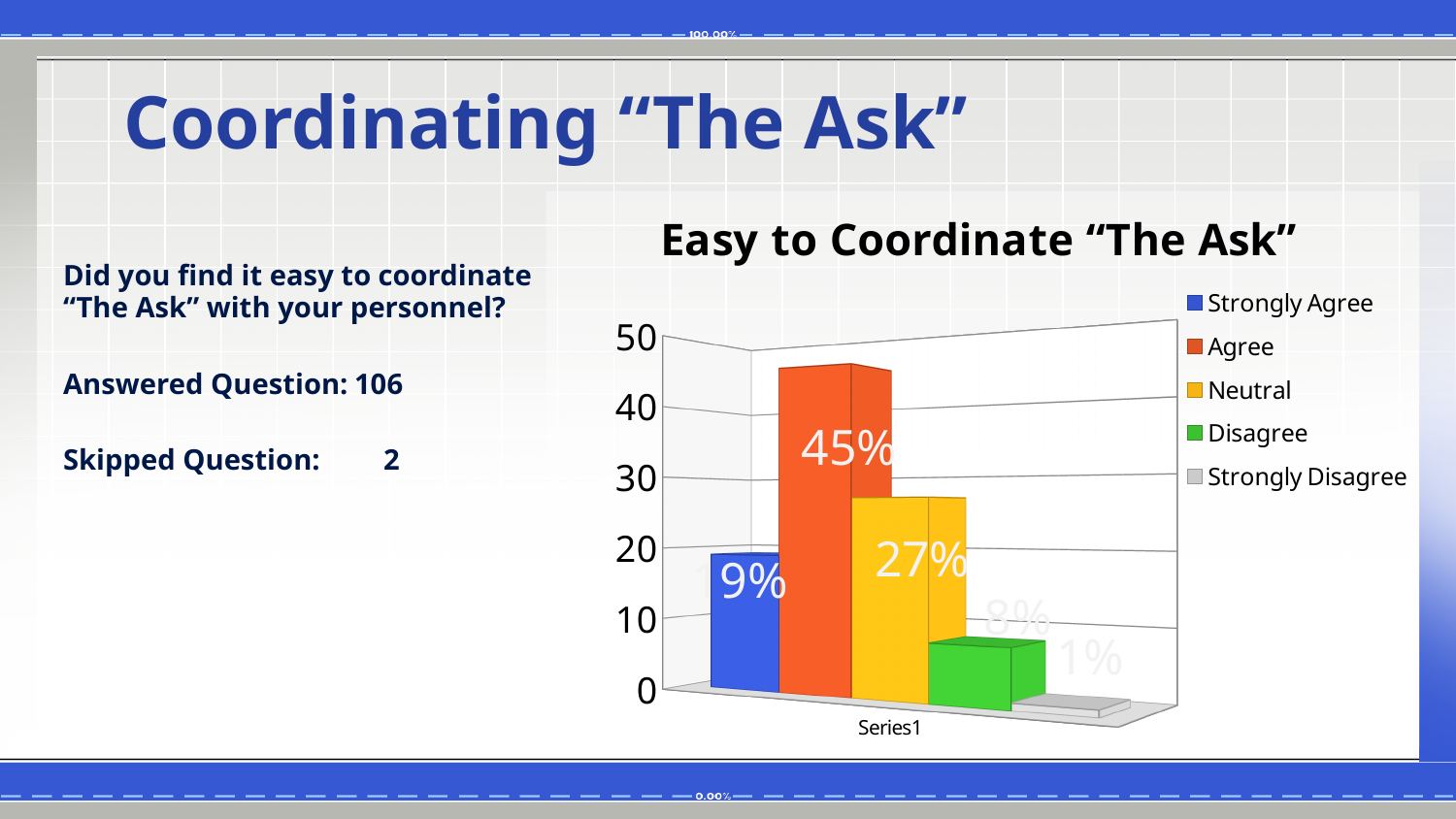
What is the value for Strongly Disagree in the Easy to Coordinate "The Ask" chart? 1% What is the value for Disagree in the Easy to Coordinate "The Ask" chart? 8% How many entries does the legend of the Easy to Coordinate "The Ask" chart list? 5 Is the value for Strongly Agree in the Easy to Coordinate "The Ask" chart greater or less than 10? greater What is the value for Neutral in the Easy to Coordinate "The Ask" chart? 27% Which response has the lowest value in the Easy to Coordinate "The Ask" chart? Strongly Disagree Which is larger in the Easy to Coordinate "The Ask" chart, Neutral or Disagree? Neutral What is the value for Agree in the Easy to Coordinate "The Ask" chart? 45% What is the title of the chart on the slide? Easy to Coordinate "The Ask" Which response has the highest value in the Easy to Coordinate "The Ask" chart? Agree What kind of chart is the Easy to Coordinate "The Ask" chart? bar chart What is the difference between the Agree and Neutral values in the Easy to Coordinate "The Ask" chart? 18%